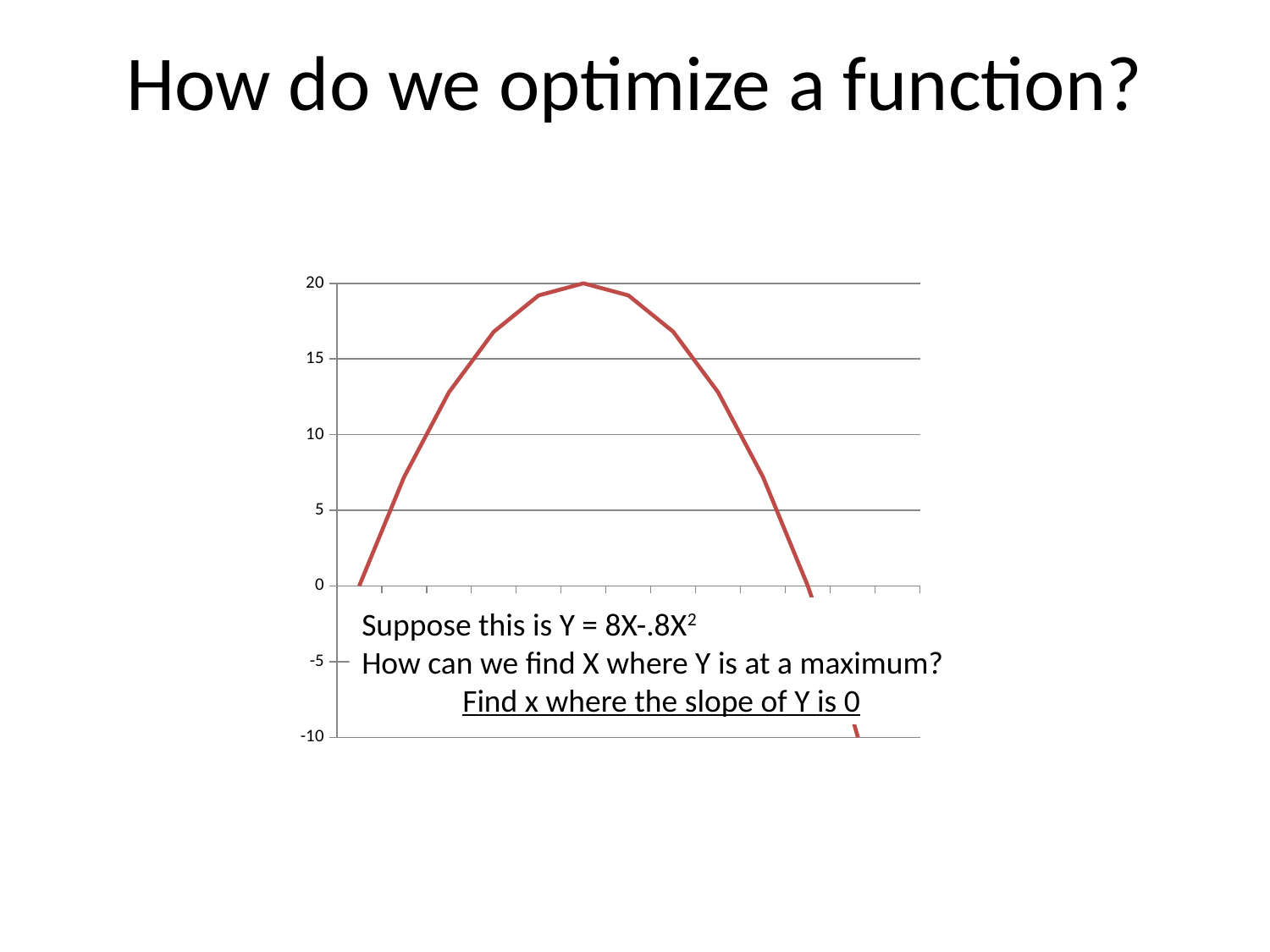
Does the plotted line rise or fall as it moves from the middle toward the right edge of the chart? fall How many lines (series) are plotted on the chart? 1 What is the lowest tick label shown on the y axis? -10 Is the peak of the plotted line greater or less than 15? greater What kind of chart is shown on the slide? line chart What value does the plotted line start at on the left end of the chart? 0 What is the highest value the plotted line reaches on the y axis? 20 According to the text on the slide, what function does the plotted line represent? Y = 8X-.8X² What is the highest tick label shown on the y axis? 20 Does the plotted line rise or fall as it moves from the left edge toward the middle of the chart? rise